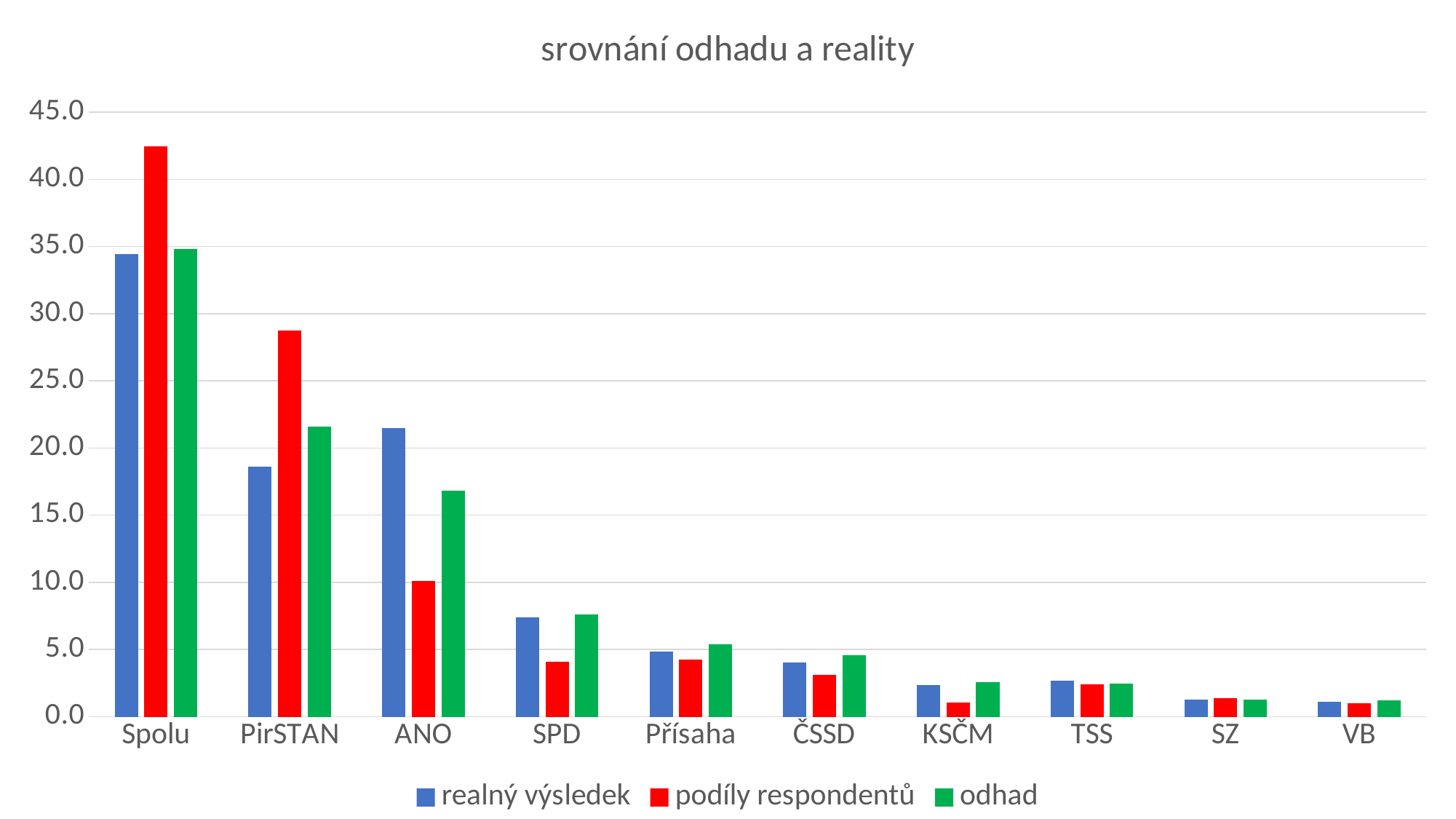
What is the title of the chart? srovnání odhadu a reality Is the realný výsledek value for SPD greater or less than 5.0? greater Is the podíly respondentů value for Spolu greater or less than 40.0? greater What kind of chart is shown on the slide? bar chart How many categories are shown on the x axis? 10 Is the odhad value for ANO greater or less than 15.0? greater Which category has the highest value for podíly respondentů? Spolu For PirSTAN, which is larger: podíly respondentů or odhad? podíly respondentů What colour represents the odhad series? green For ANO, which is larger: realný výsledek or podíly respondentů? realný výsledek How many series does the legend list? 3